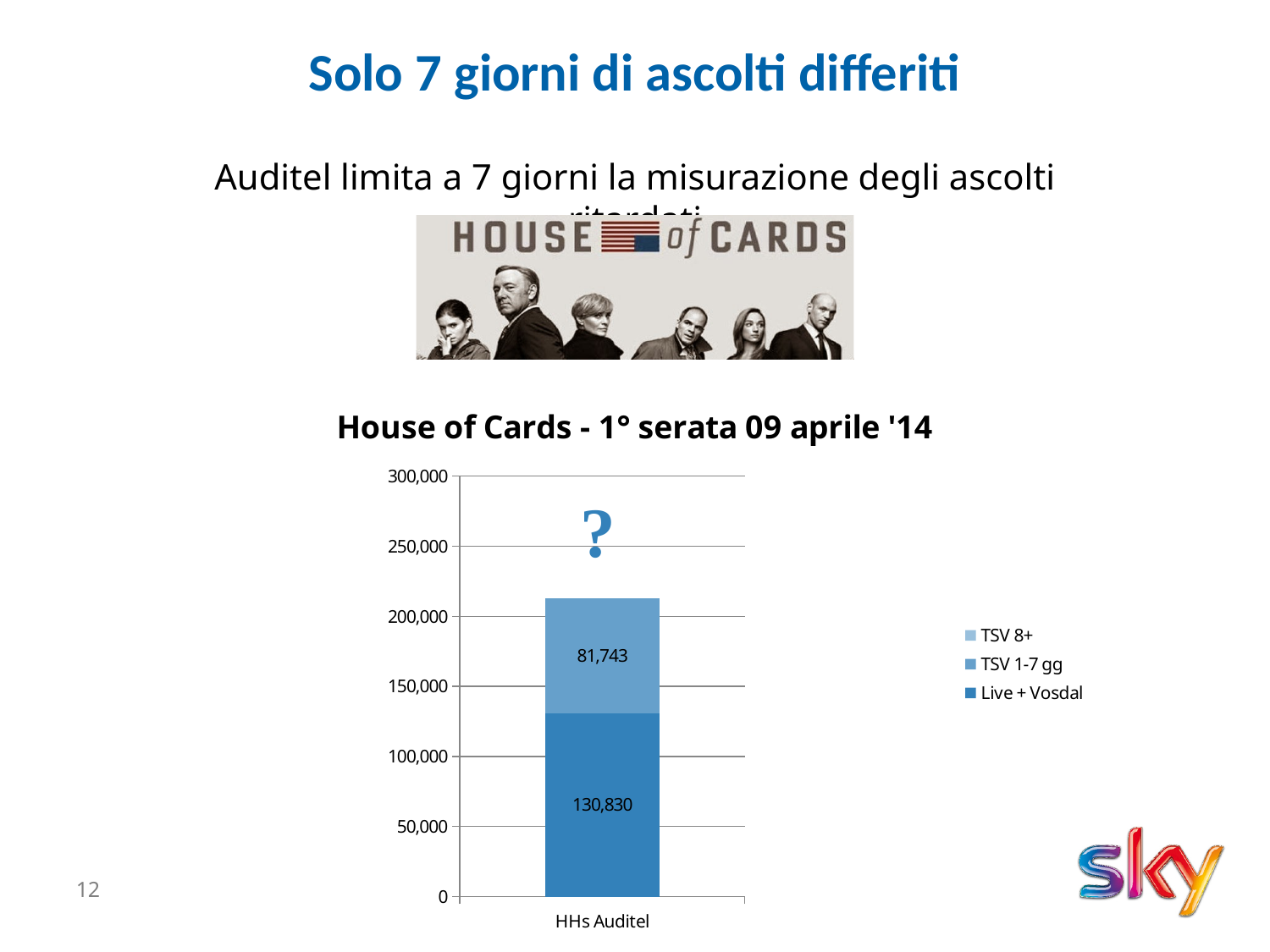
What is the value of the TSV 1-7 gg segment for HHs Auditel? 81,743 Is the Live + Vosdal segment greater or less than 100,000? greater What type of chart is shown on the slide? Stacked bar chart How many categories are shown on the x axis of the chart? 1 What is the value of the Live + Vosdal segment for HHs Auditel? 130,830 What is the title of the chart? House of Cards - 1° serata 09 aprile '14 What symbol is shown above the bar in place of a value for the TSV 8+ series? ? How many series does the chart legend list? 3 Which segment of the HHs Auditel bar is larger, Live + Vosdal or TSV 1-7 gg? Live + Vosdal What is the combined value of the Live + Vosdal and TSV 1-7 gg segments? 212,573 What is the difference between the Live + Vosdal value and the TSV 1-7 gg value? 49,087 Is the top of the HHs Auditel stacked bar greater or less than 200,000? greater